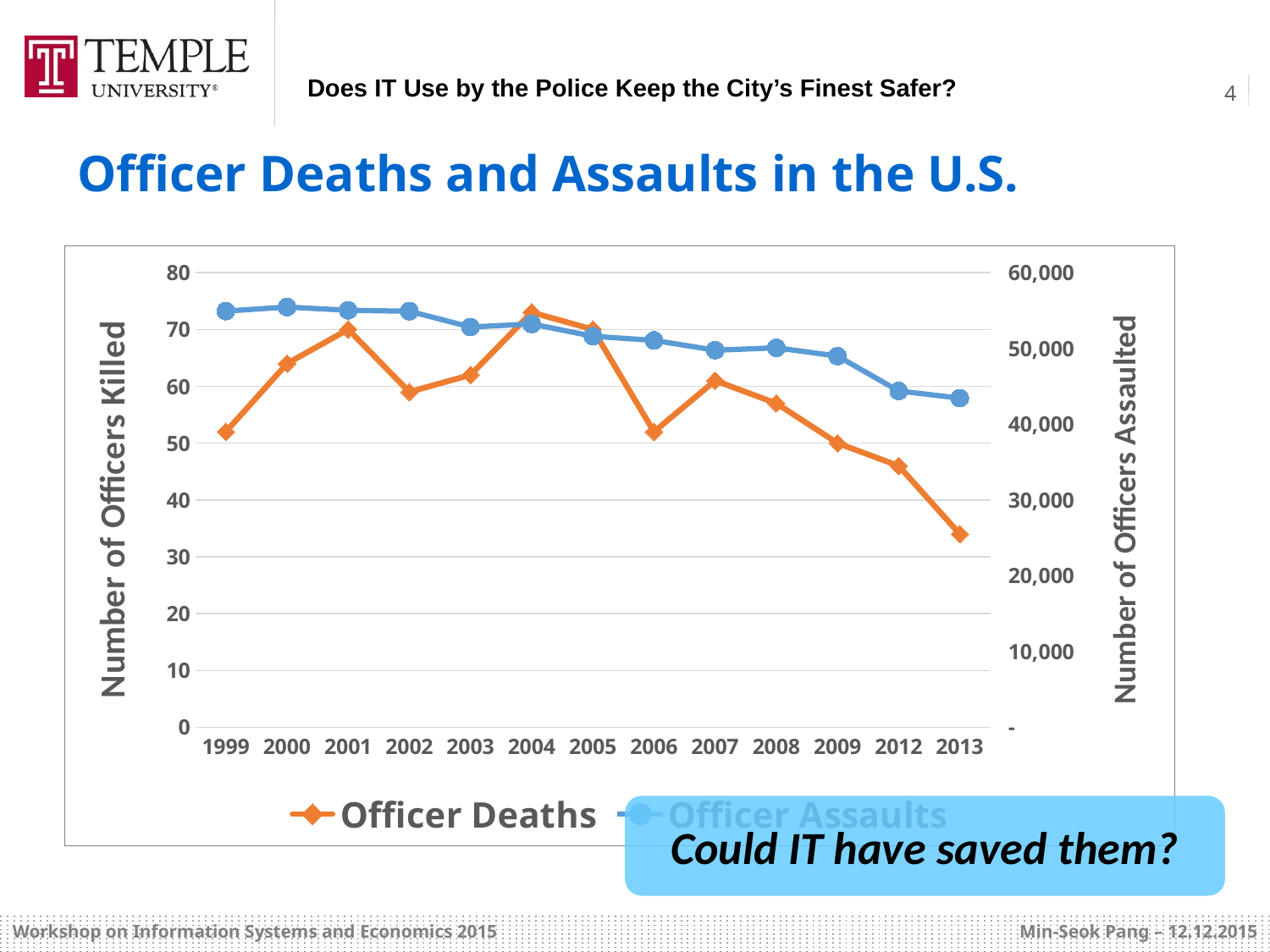
Is the Officer Deaths value for 2013 greater or less than 40? less What kind of chart is shown on the slide? Line chart In which year is the Officer Deaths series at its lowest? 2013 Is the Officer Assaults value for 2013 greater or less than 50,000? less In which year is the Officer Deaths series at its highest? 2004 Does the Officer Assaults series generally rise or fall from 1999 to 2013? Fall Which year has more Officer Deaths, 2004 or 2006? 2004 Is the Officer Deaths value for 2012 greater or less than 50? less How many years are plotted along the x axis? 13 How many series does the legend list? 2 In which year is the Officer Assaults series at its lowest? 2013